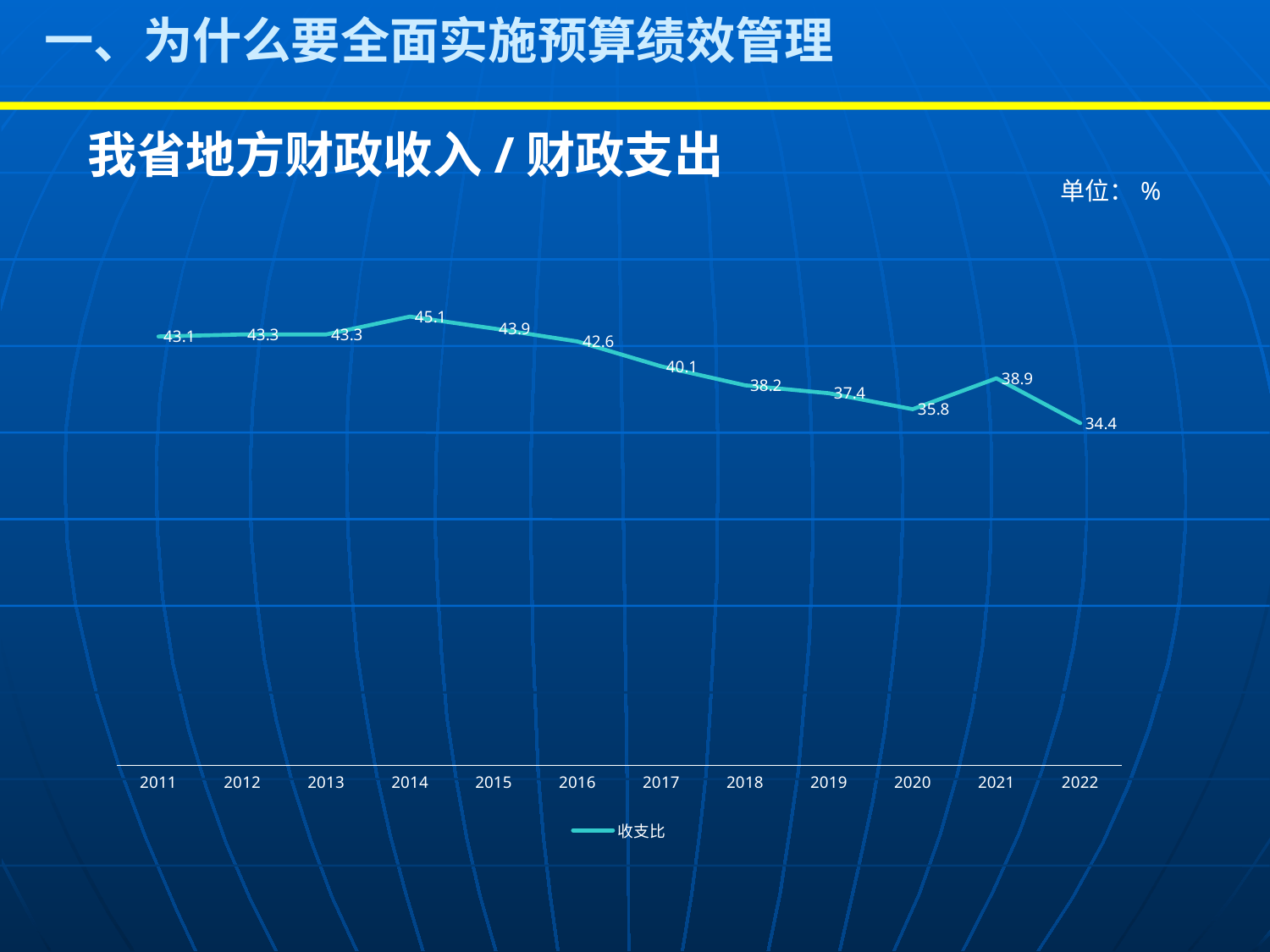
Which year has the lowest value? 2022 What is the value for 2018? 38.2 What is the difference between the values for 2020 and 2021? 3.1 What kind of chart is shown? line chart Do the values generally rise or fall from 2014 to 2020? fall Which year has the highest value? 2014 Which is larger, the value for 2017 or the value for 2021? 2017 What is the difference between the values for 2014 and 2022? 10.7 What is the value for 2022? 34.4 How many series does the legend list? 1 What is the value for 2014? 45.1 How many years are plotted on the chart? 12